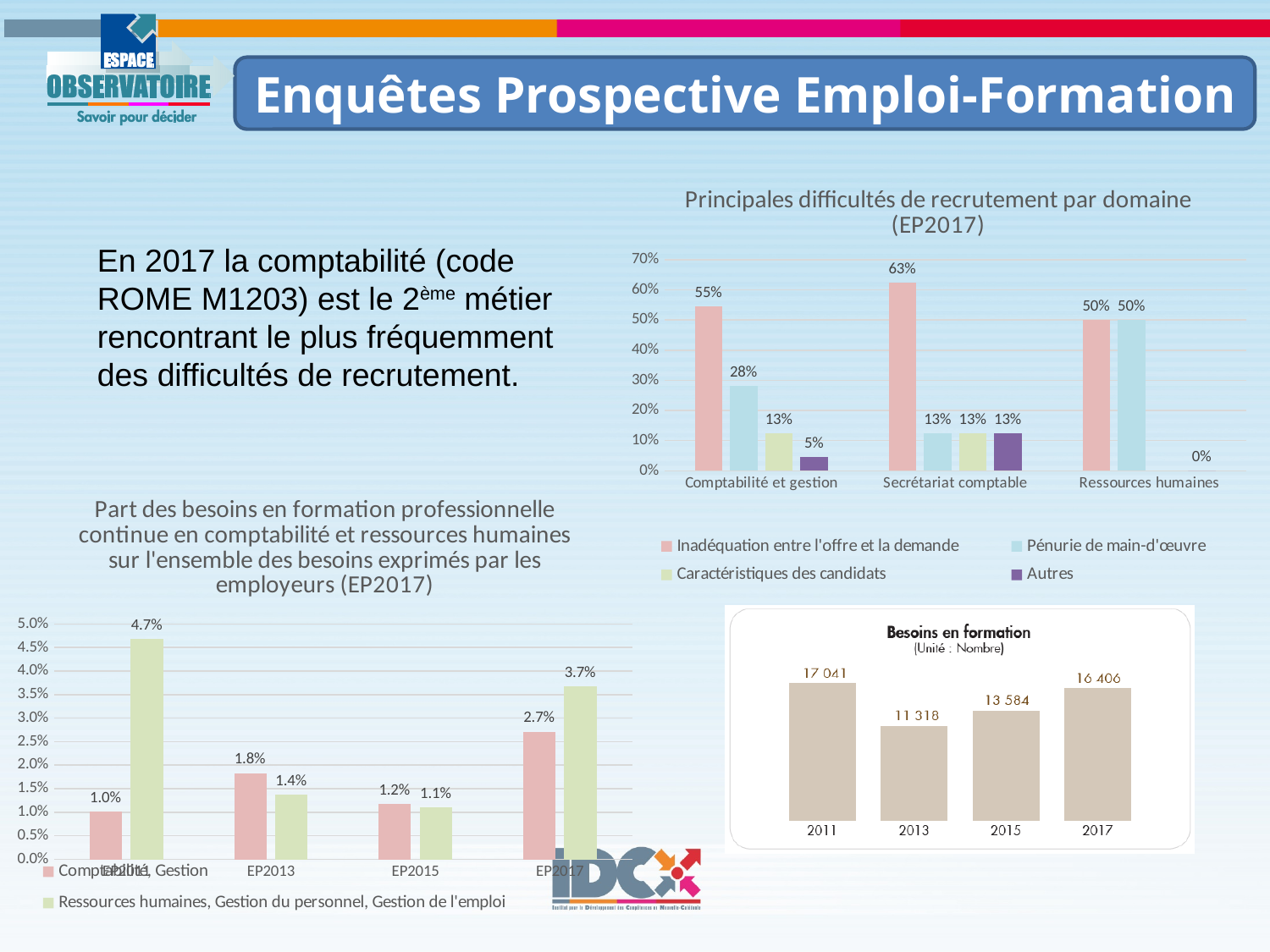
What kind of chart is 'Besoins en formation' (bottom right)? Bar chart In the chart 'Part des besoins en formation professionnelle continue...' (bottom left), which survey year has the highest value for 'Ressources humaines, Gestion du personnel, Gestion de l'emploi'? EP2011 In the chart 'Principales difficultés de recrutement par domaine (EP2017)', which domain has the highest value for 'Inadéquation entre l'offre et la demande'? Secrétariat comptable In the chart 'Besoins en formation' (bottom right), what is the value for 2013? 11 318 How many survey years are shown on the x axis of the chart 'Part des besoins en formation professionnelle continue...' (bottom left)? 4 In the chart 'Part des besoins en formation professionnelle continue...' (bottom left), which is larger in EP2013: 'Comptabilité, Gestion' or 'Ressources humaines, Gestion du personnel, Gestion de l'emploi'? Comptabilité, Gestion In the chart 'Principales difficultés de recrutement par domaine (EP2017)', what is the value of 'Inadéquation entre l'offre et la demande' for Secrétariat comptable? 63% In the chart 'Principales difficultés de recrutement par domaine (EP2017)', what is the difference between 'Inadéquation entre l'offre et la demande' and 'Autres' for Comptabilité et gestion? 50% In the chart 'Besoins en formation' (bottom right), which year has the lowest value? 2013 In the chart 'Part des besoins en formation professionnelle continue...' (bottom left), what is the value for 'Comptabilité, Gestion' in EP2017? 2.7% How many series does the legend of the chart 'Principales difficultés de recrutement par domaine (EP2017)' list? 4 In the chart 'Principales difficultés de recrutement par domaine (EP2017)', what is the value of 'Pénurie de main-d'œuvre' for Comptabilité et gestion? 28%